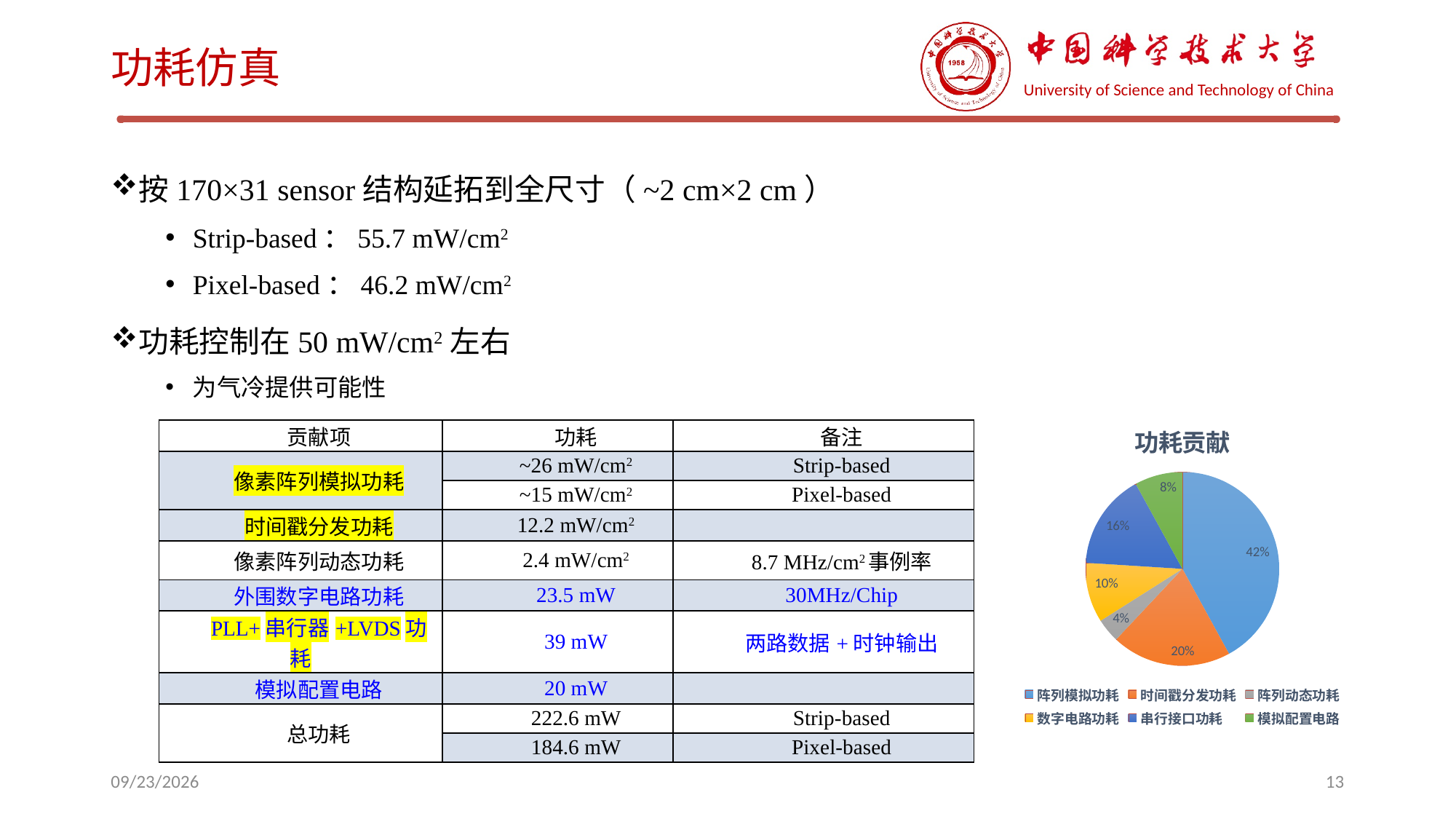
In the 功耗贡献 pie chart, what share does 数字电路功耗 have? 10% Which category has the largest slice in the 功耗贡献 pie chart? 阵列模拟功耗 In the 功耗贡献 pie chart, what share does 串行接口功耗 have? 16% In the 功耗贡献 pie chart, which is larger: 串行接口功耗 or 数字电路功耗? 串行接口功耗 What kind of chart is shown on the slide? pie chart How many categories does the 功耗贡献 pie chart show? 6 Which category has the smallest slice in the 功耗贡献 pie chart? 阵列动态功耗 In the 功耗贡献 pie chart, what share does 模拟配置电路 have? 8% What is the title of the pie chart? 功耗贡献 In the 功耗贡献 pie chart, what is the difference between the shares of 阵列模拟功耗 and 时间戳分发功耗? 22%